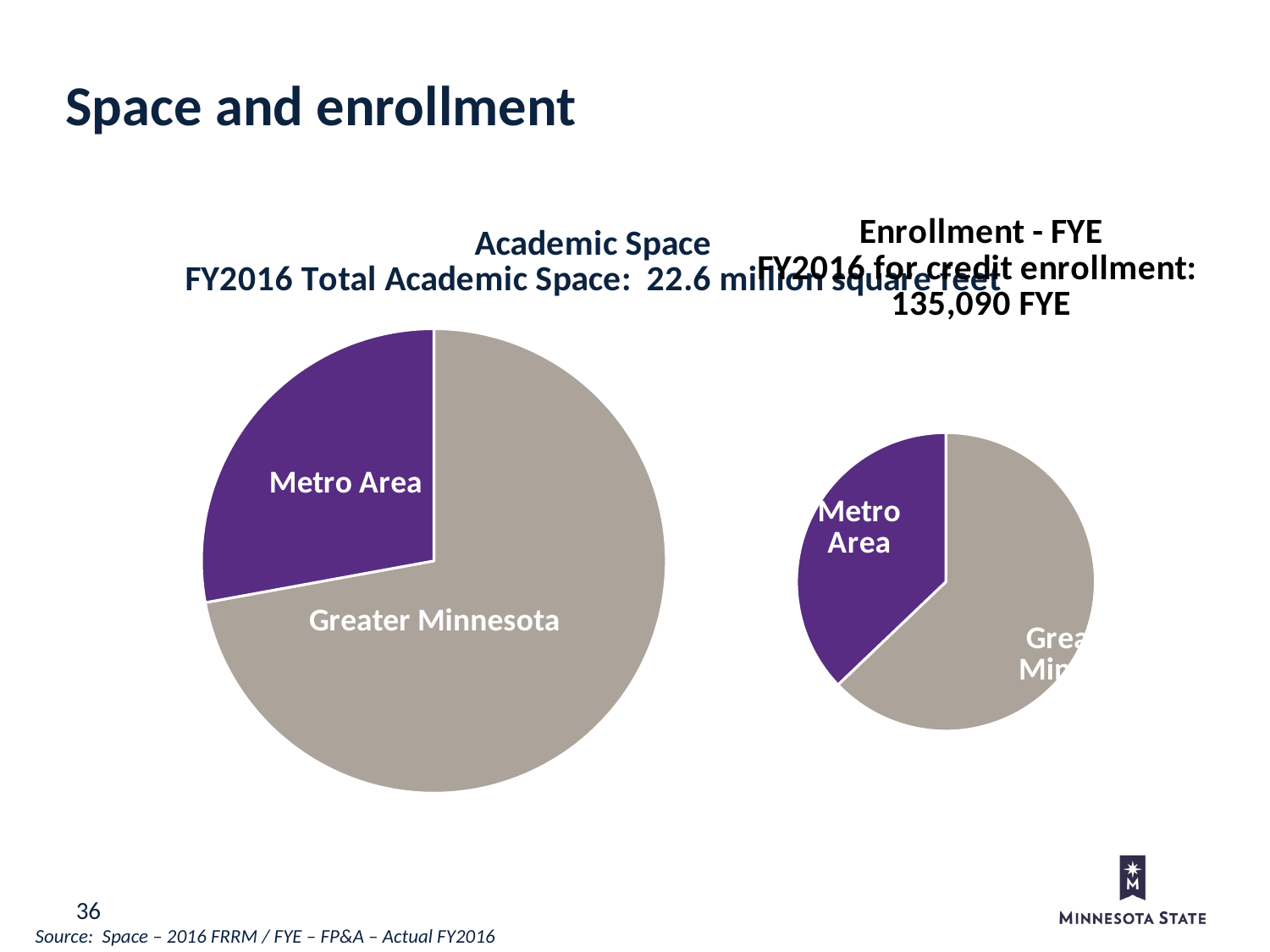
In the Academic Space pie chart, is the Metro Area slice larger or smaller than the Greater Minnesota slice? Smaller In the Enrollment - FYE pie chart, which category has the smallest slice? Metro Area In the Academic Space pie chart, which category has the largest slice? Greater Minnesota What kind of chart is the Academic Space chart on the left? Pie chart How many slices does the Enrollment - FYE pie chart have? 2 In the Academic Space pie chart, which category has the smallest slice? Metro Area According to the title of the Enrollment - FYE chart, what is the FY2016 for credit enrollment? 135,090 FYE What kind of chart is the Enrollment - FYE chart on the right? Pie chart In the Enrollment - FYE pie chart, which slice is larger, Metro Area or Greater Minnesota? Greater Minnesota According to the title of the Academic Space chart, what is the FY2016 total academic space? 22.6 million square feet How many slices does the Academic Space pie chart have? 2